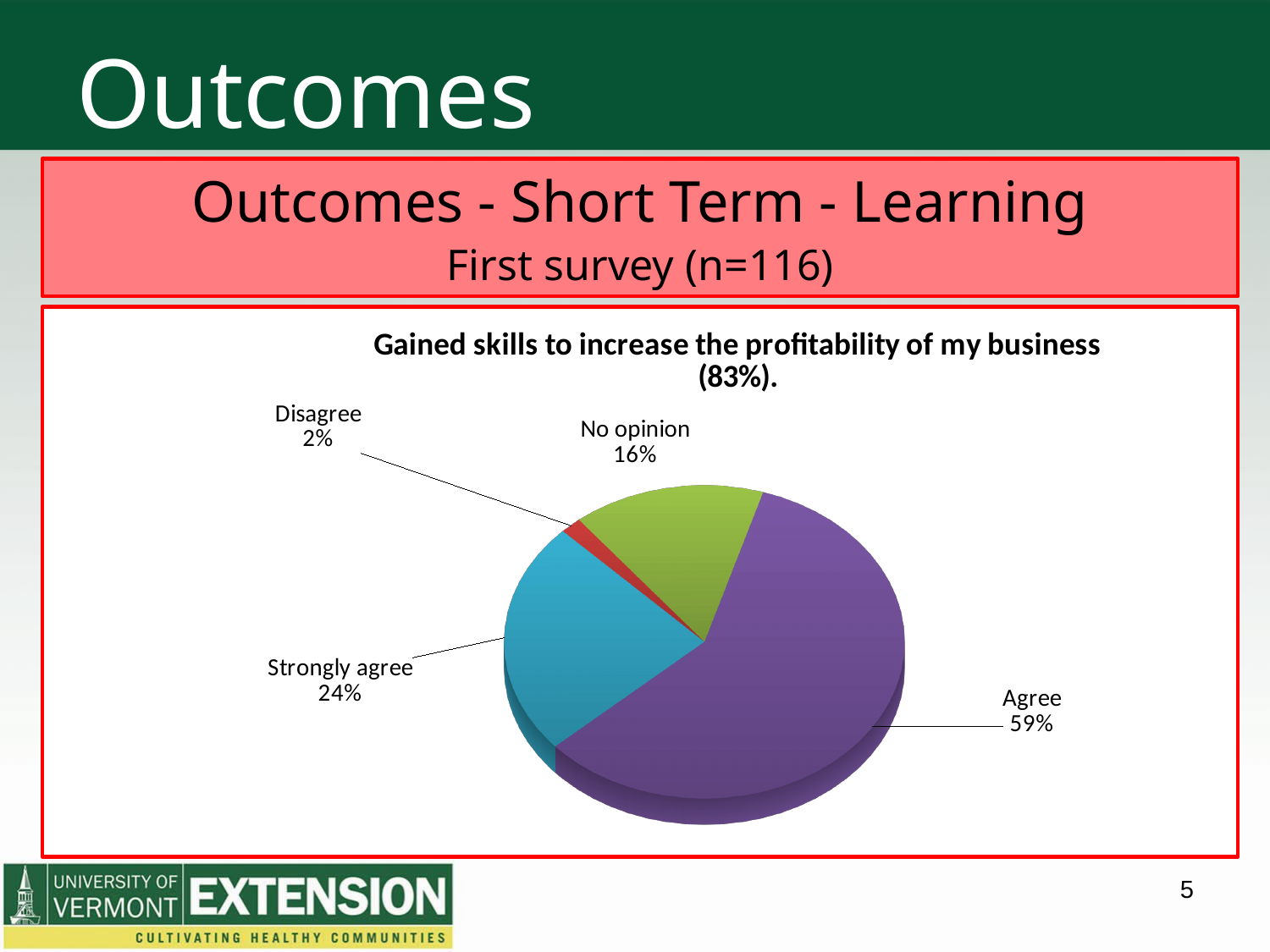
What percentage of respondents answered "No opinion"? 16% How many response categories are shown in the pie chart? 4 Which is larger: the share for "No opinion" or the share for "Strongly agree"? Strongly agree Which response category has the largest share of the pie? Agree What is the title of the pie chart? Gained skills to increase the profitability of my business (83%). What is the difference in percentage points between "Agree" and "Strongly agree"? 35 What percentage of respondents answered "Disagree"? 2% What is the combined percentage of "Agree" and "Strongly agree" responses? 83% What percentage of respondents answered "Strongly agree"? 24% What type of chart is shown on the slide? Pie chart Which response category has the smallest share of the pie? Disagree What percentage of respondents answered "Agree"? 59%